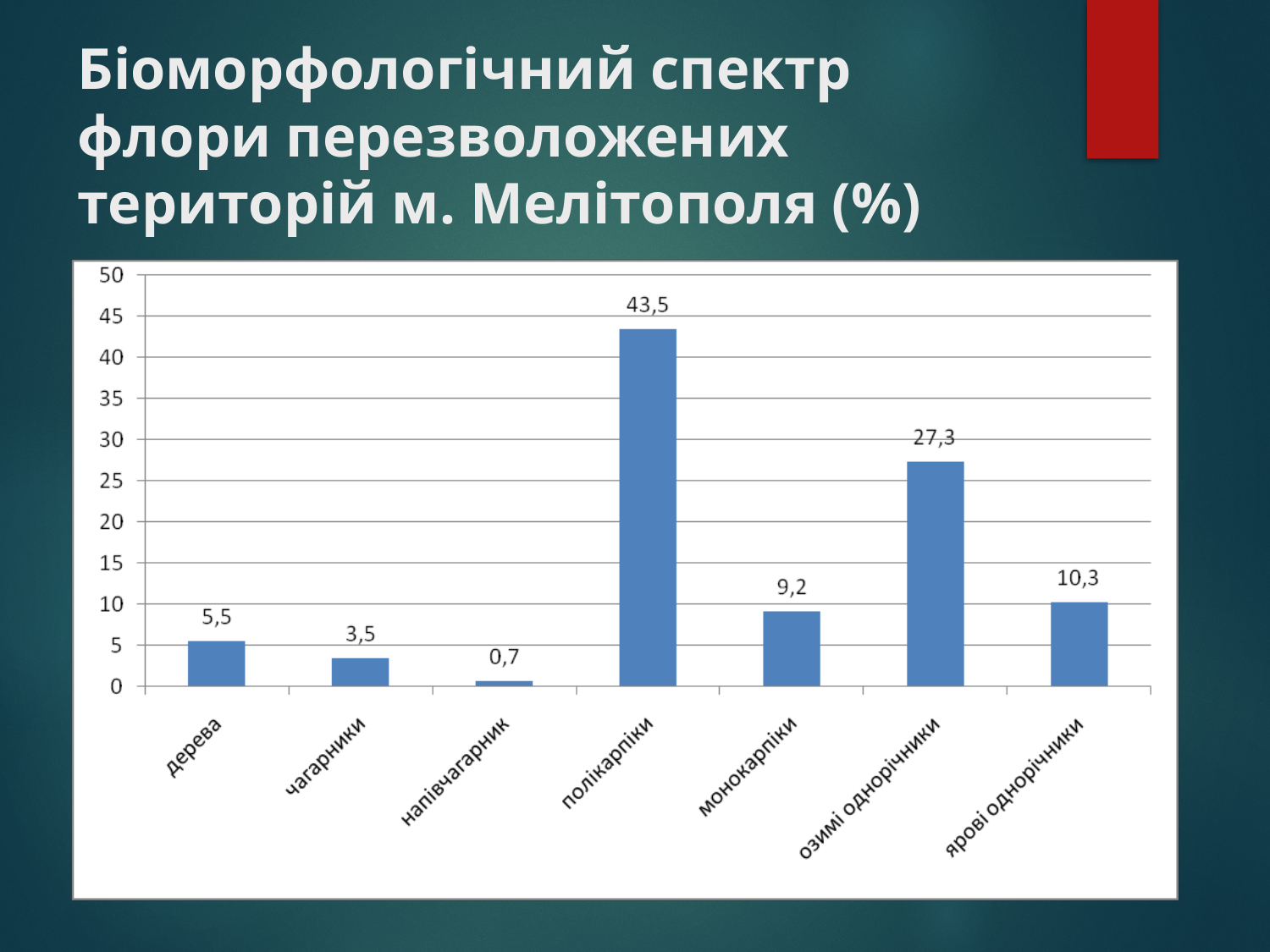
What is the value for озимі однорічники? 27,3 What is the difference between the values for полікарпіки and озимі однорічники? 16,2 Which category has the highest value? полікарпіки What is the value for ярові однорічники? 10,3 Which is larger, the value for дерева or the value for чагарники? дерева What is the value for напівчагарник? 0,7 What is the value for полікарпіки? 43,5 What is the difference between the values for ярові однорічники and монокарпіки? 1,1 What kind of chart is shown on the slide? bar chart Is the value for монокарпіки greater or less than 10? less How many categories are shown on the x axis? 7 Which category has the lowest value? напівчагарник